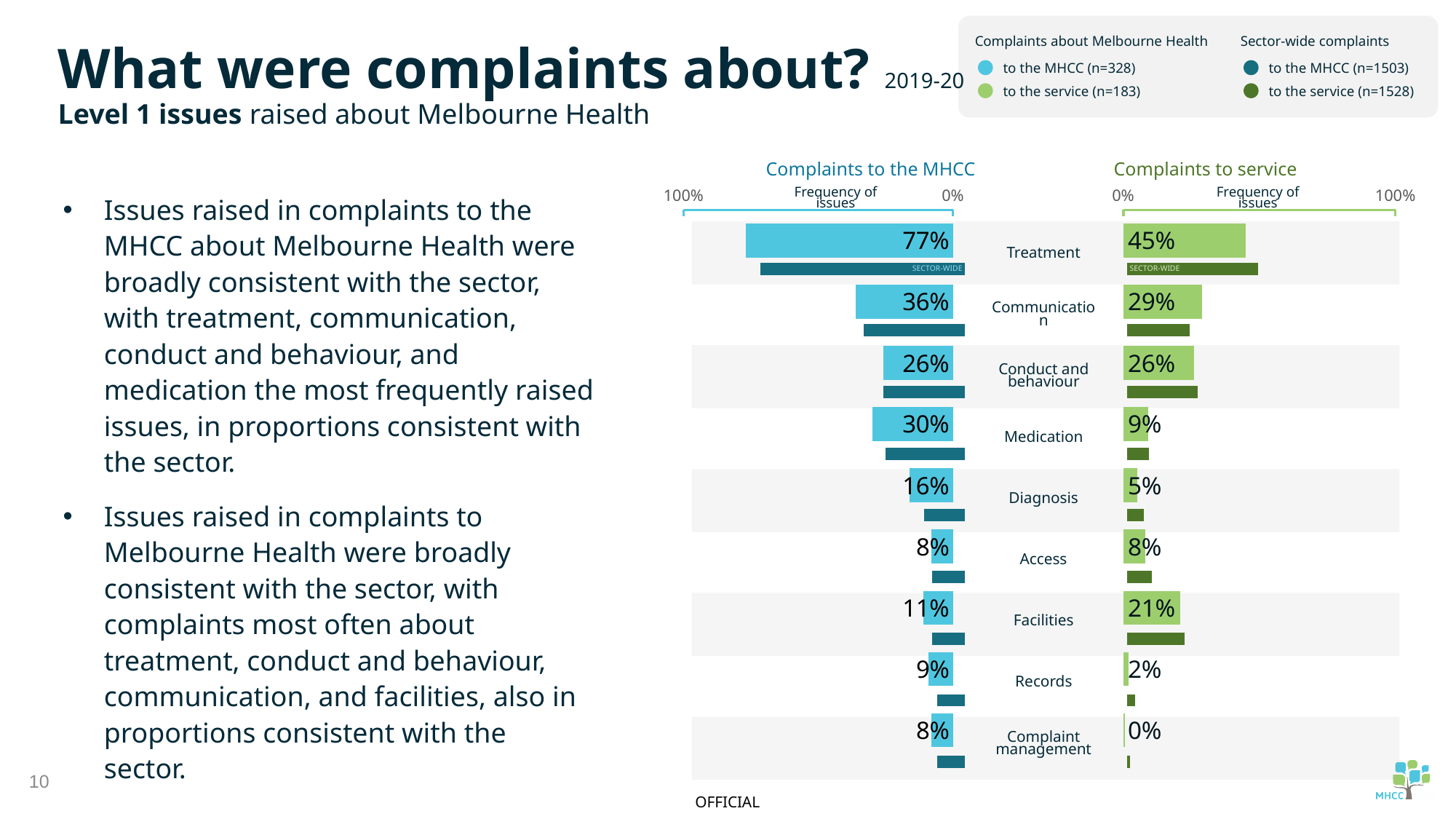
In the 'Complaints to service' chart, what is the difference between the values for Treatment and Conduct and behaviour? 19% In the 'Complaints to service' chart, which is larger: Facilities or Medication? Facilities In the 'Complaints to the MHCC' chart, what is the difference between the Melbourne Health values for Treatment and Communication? 41% In the 'Complaints to service' chart, which issue has the lowest frequency? Complaint management In the 'Complaints to the MHCC' chart, which is larger for Melbourne Health: Medication or Conduct and behaviour? Medication In the 'Complaints to service' chart, what percentage of complaints raised Facilities? 21% In the 'Complaints to service' chart, what percentage of complaints raised Records? 2% What type of chart is used to show the frequency of issues? Bar chart In the 'Complaints to the MHCC' chart, which issue has the highest frequency for Melbourne Health? Treatment In the 'Complaints to the MHCC' chart, what percentage of Melbourne Health complaints raised Treatment? 77% How many series does the legend at the top of the slide list? 4 How many issue categories are listed in the charts? 9